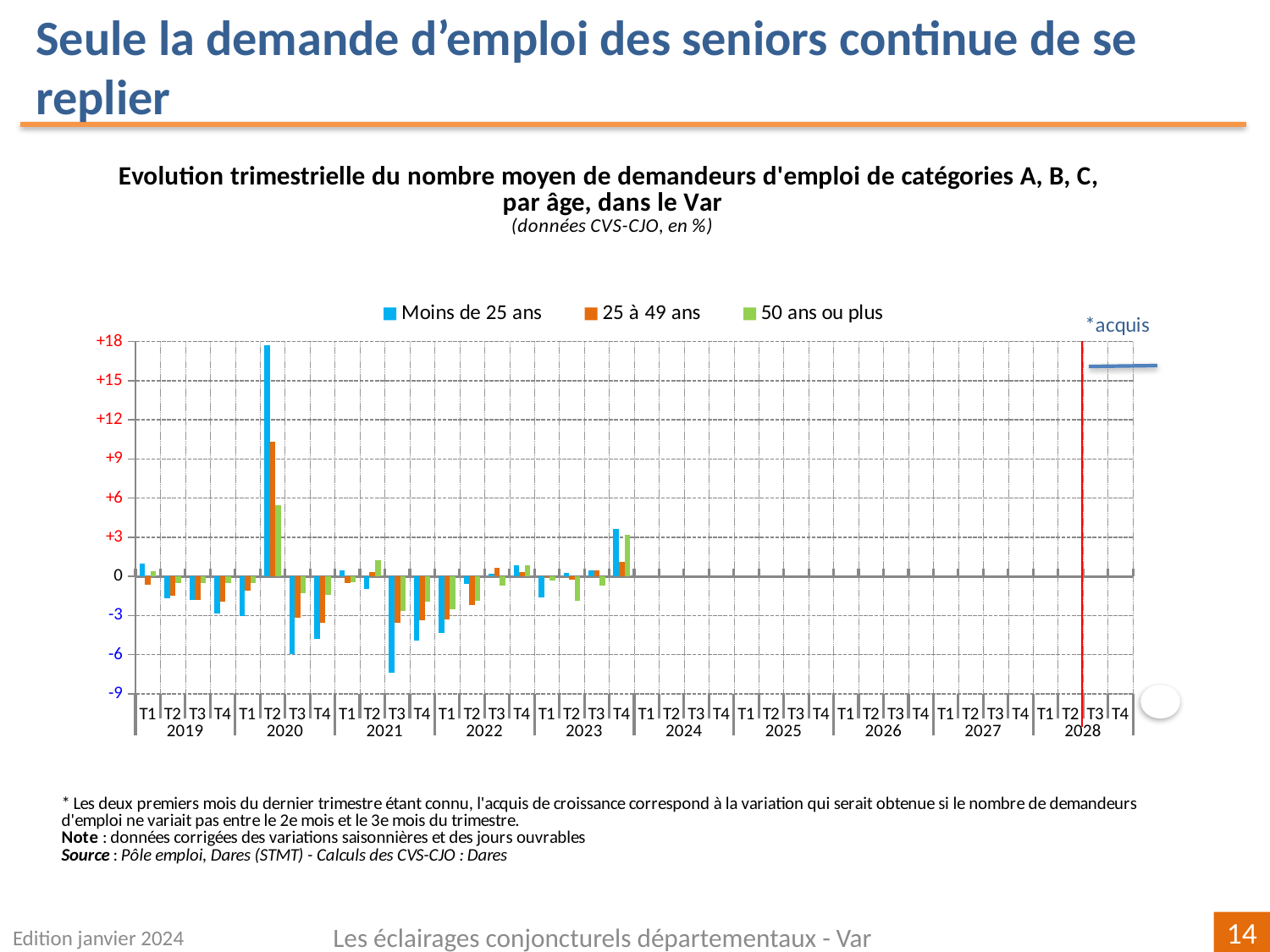
Which series and quarter has the highest value on the chart? Moins de 25 ans, T2 2020 Is the value for Moins de 25 ans in T3 2021 greater or less than -6? less Which year on the x axis is marked by the red vertical line? 2028 Is the value for 25 à 49 ans in T2 2020 greater or less than +9? greater Is the value for 50 ans ou plus in T2 2020 greater or less than +3? greater What kind of chart is shown on the slide? bar chart How many years are labelled along the x axis? 10 Which series is shown in blue in the legend? Moins de 25 ans In T2 2020, which is larger: the value for Moins de 25 ans or the value for 25 à 49 ans? Moins de 25 ans How many series does the legend list? 3 Which series and quarter has the lowest value on the chart? Moins de 25 ans, T3 2021